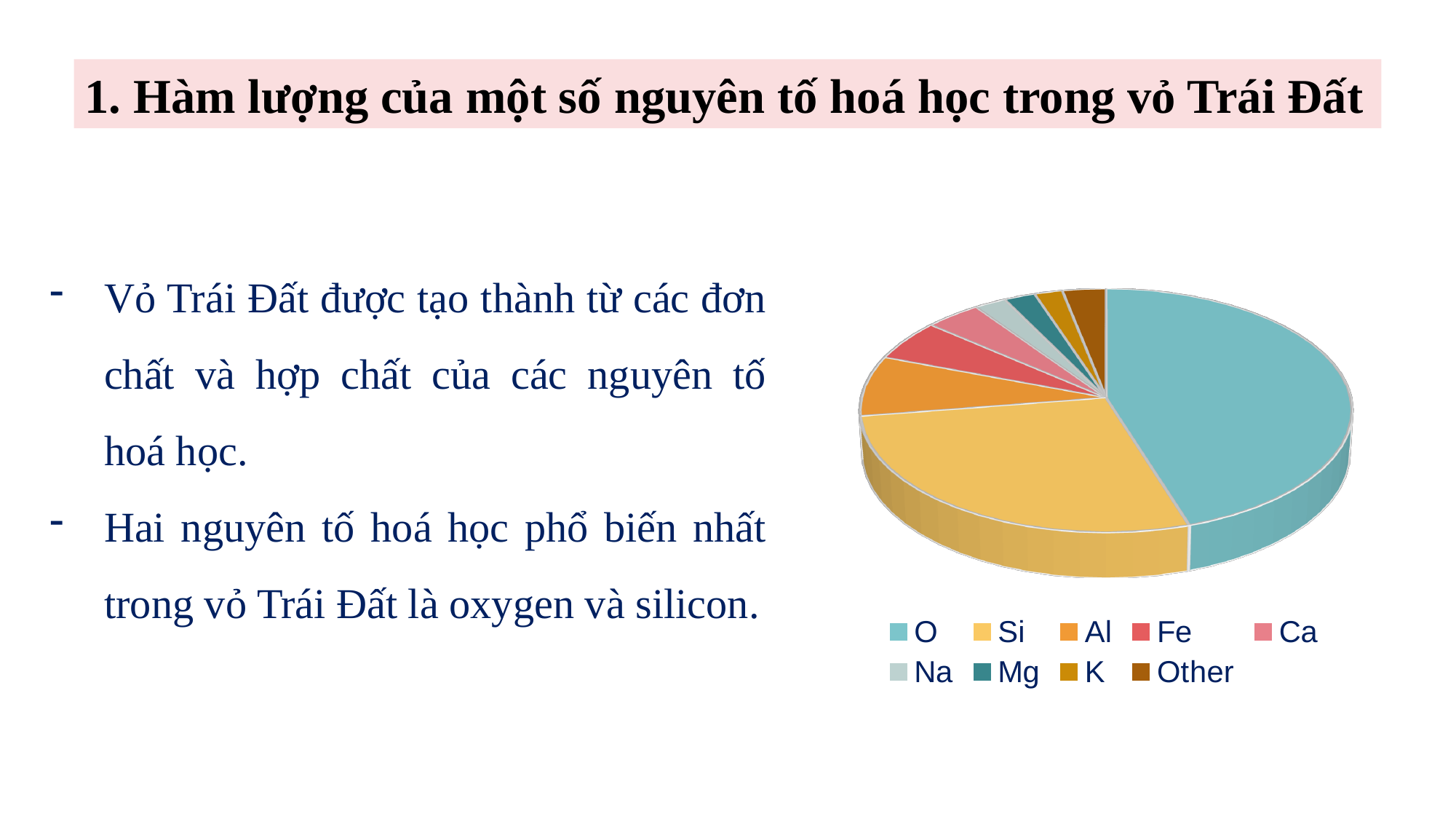
Which slice is larger in the pie chart, Si or Fe? Si Which slice is larger in the pie chart, Si or Al? Si What is the last entry listed in the pie chart's legend? Other What kind of chart is shown on the slide? pie chart Which slice is larger in the pie chart, O or Si? O Which legend entry in the pie chart is shown in light blue (teal)? O Which element has the largest slice in the pie chart? O How many categories does the pie chart's legend list? 9 Which element has the second-largest slice in the pie chart? Si